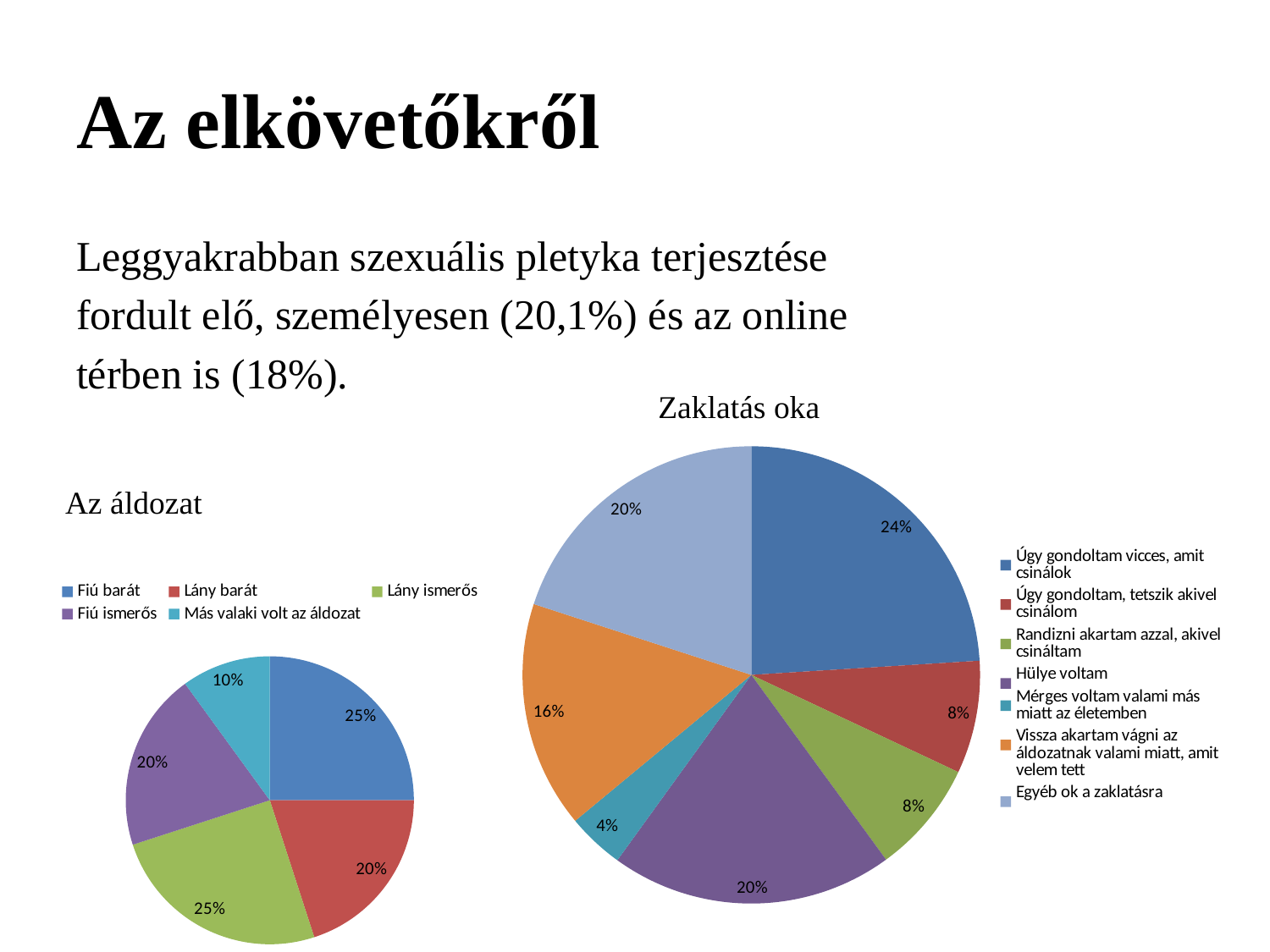
In the 'Zaklatás oka' chart, which is larger: 'Vissza akartam vágni az áldozatnak valami miatt, amit velem tett' or 'Randizni akartam azzal, akivel csináltam'? Vissza akartam vágni az áldozatnak valami miatt, amit velem tett In the 'Zaklatás oka' chart, which category has the largest share? Úgy gondoltam vicces, amit csinálok In the 'Az áldozat' chart, what share does 'Más valaki volt az áldozat' have? 10% In the 'Zaklatás oka' chart, how many categories does the legend list? 7 In the 'Az áldozat' chart, what share does 'Fiú barát' have? 25% In the 'Az áldozat' chart, which category has the smallest share? Más valaki volt az áldozat In the 'Zaklatás oka' chart, what share does 'Hülye voltam' have? 20% In the 'Az áldozat' chart, what is the difference between the shares of 'Lány ismerős' and 'Lány barát'? 5% What type of chart is the 'Zaklatás oka' chart? Pie chart In the 'Zaklatás oka' chart, what share does 'Mérges voltam valami más miatt az életemben' have? 4% In the 'Az áldozat' chart, how many categories does the legend list? 5 In the 'Zaklatás oka' chart, which category has the smallest share? Mérges voltam valami más miatt az életemben